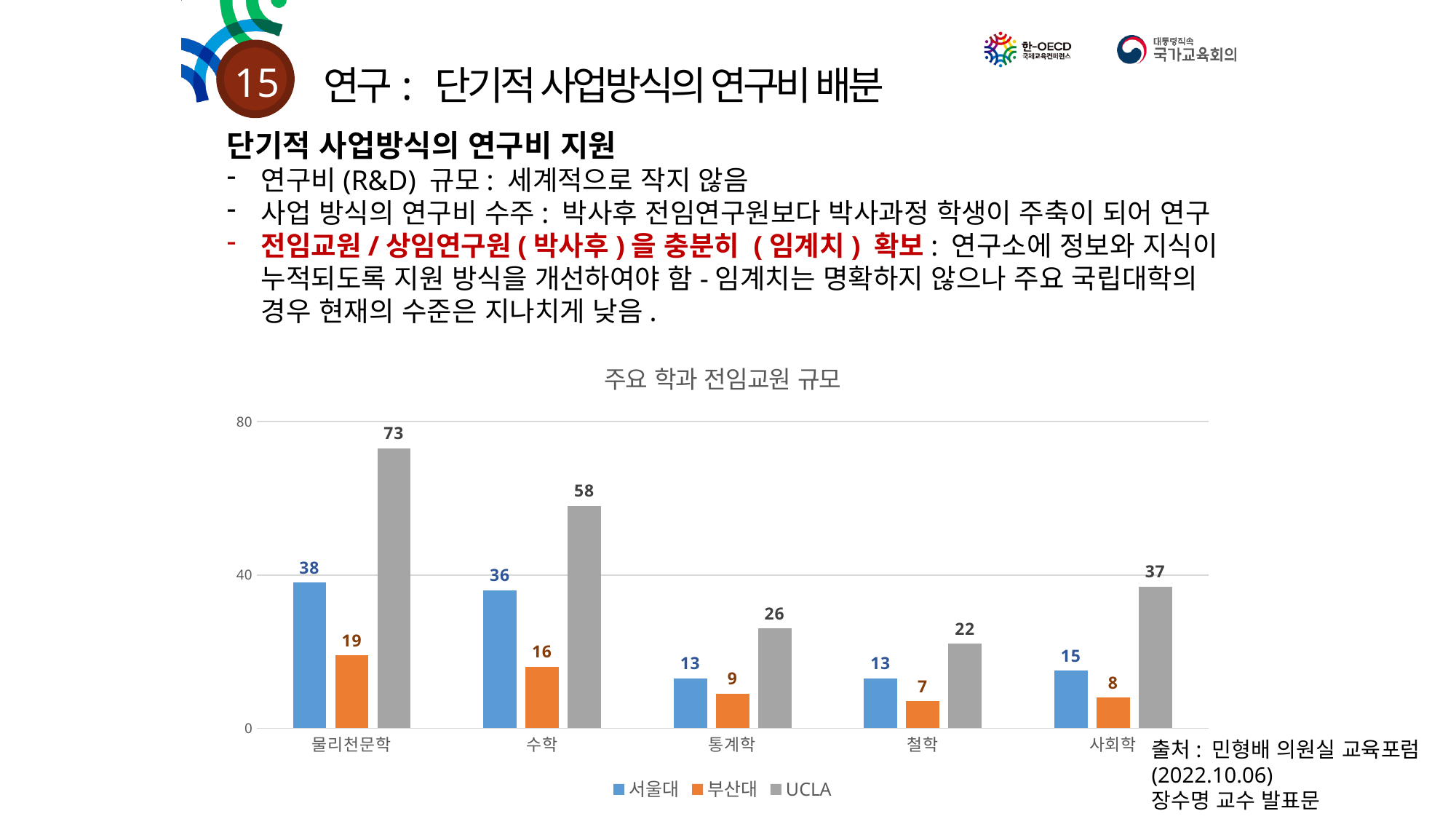
How many series does the legend list? 3 What is the title of the chart? 주요 학과 전임교원 규모 What is the value for 서울대 in the 사회학 category? 15 How many categories are shown on the x axis? 5 What is the difference between the UCLA and 서울대 values in the 수학 category? 22 Is the UCLA value for 사회학 greater or less than 40? less Which category has the highest UCLA value? 물리천문학 What is the value for 부산대 in the 수학 category? 16 Which category has the lowest 부산대 value? 철학 What kind of chart is shown on the slide? bar chart Which is larger in the 통계학 category: the 서울대 value or the UCLA value? UCLA What is the value for UCLA in the 물리천문학 category? 73